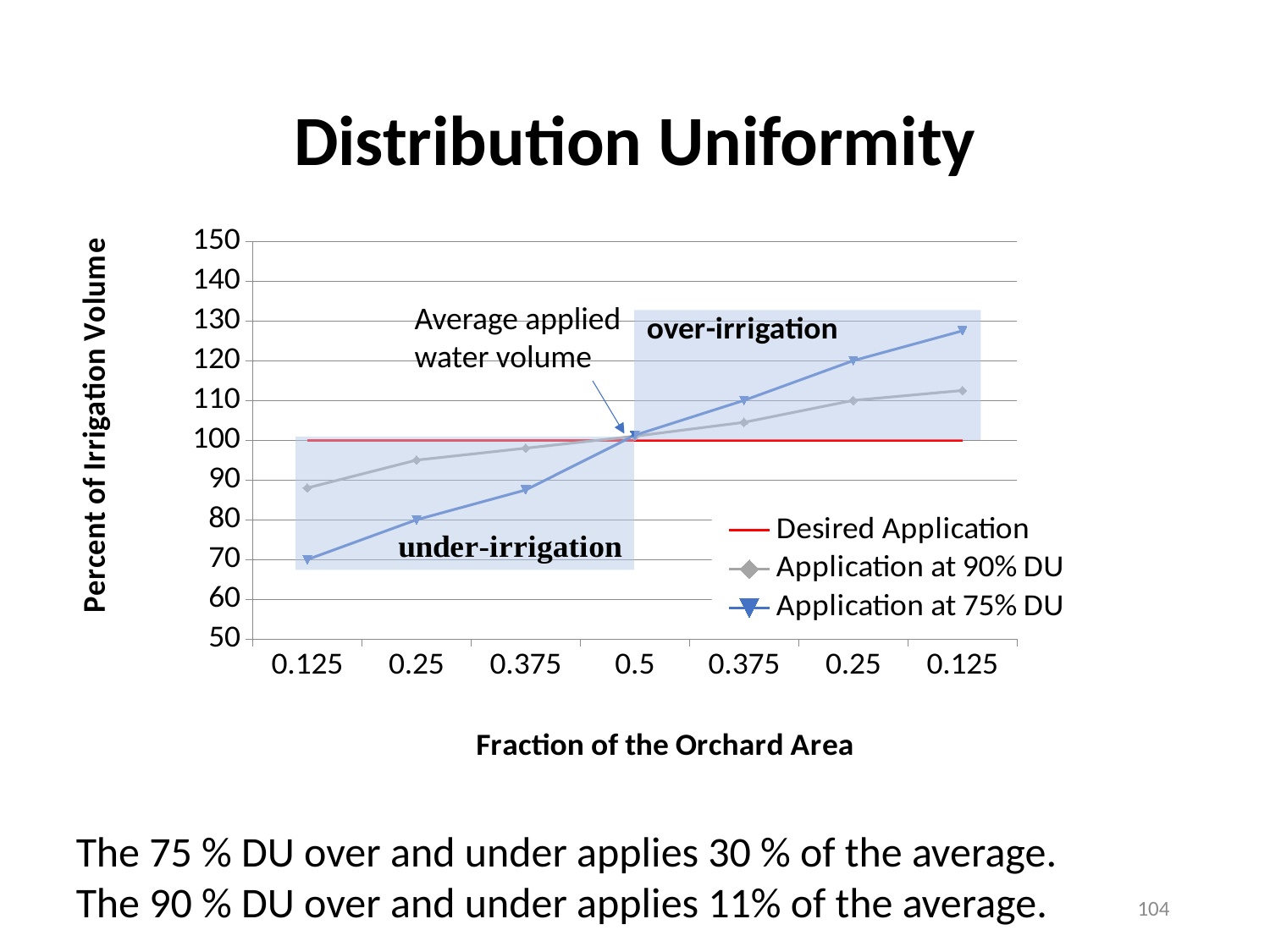
What is the title of the y axis? Percent of Irrigation Volume What kind of chart is shown on the slide? line chart Which series reaches the highest value on the chart? Application at 75% DU At the leftmost 0.125, which series is lower: Application at 75% DU or Application at 90% DU? Application at 75% DU Is the value for Application at 75% DU at the leftmost 0.125 greater or less than 80? less Is the value for Application at 75% DU at the rightmost 0.125 greater or less than 120? greater How many series does the legend list? 3 Does the Application at 75% DU line rise or fall from left to right along the x axis? rise How many points are plotted along the x axis for each series? 7 What value does the Desired Application line sit at? 100 Is the value for Application at 90% DU at the rightmost 0.125 greater or less than 120? less At the rightmost 0.125, which series is higher: Application at 75% DU or Application at 90% DU? Application at 75% DU